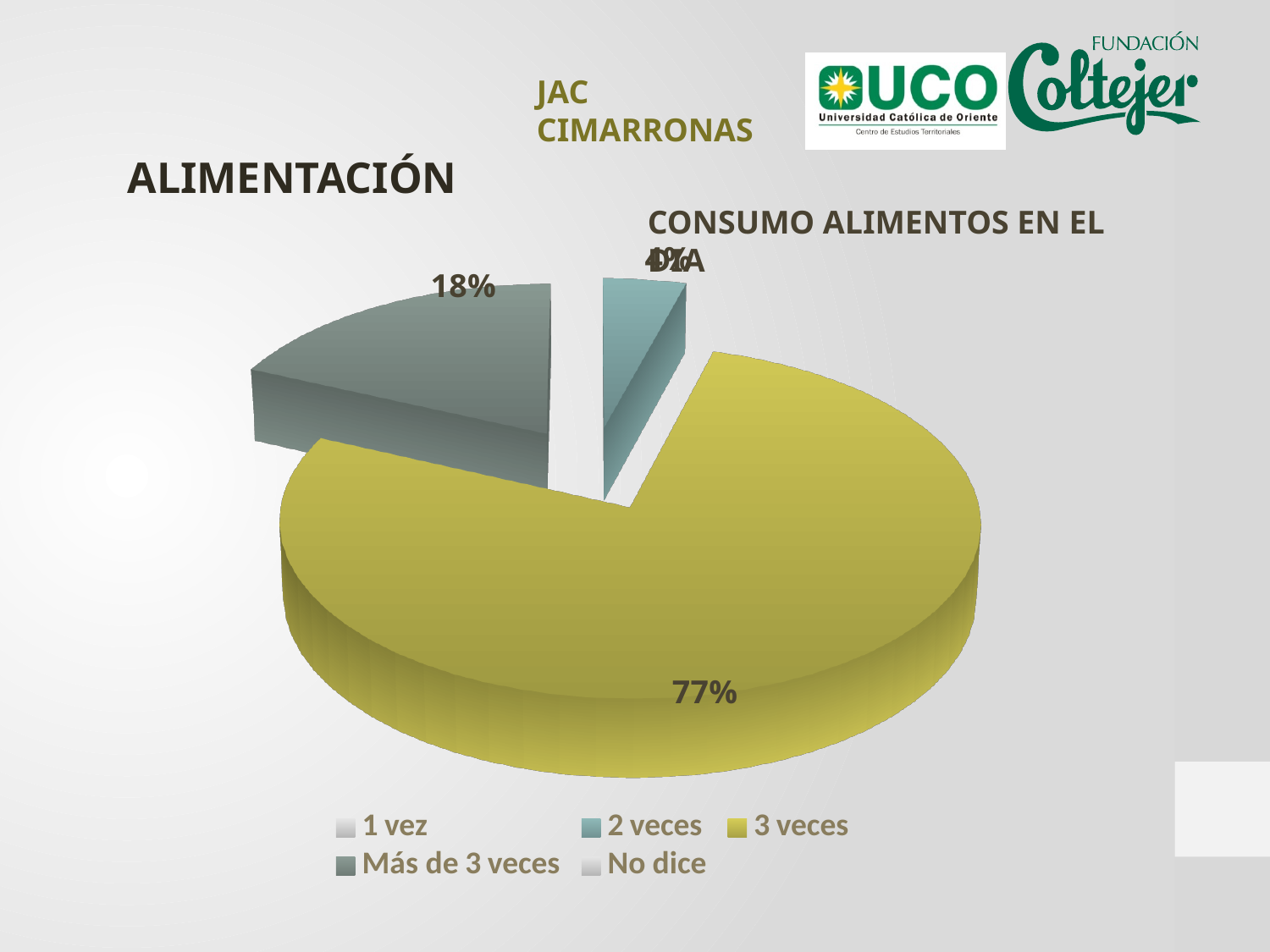
Is the share for "3 veces" greater or less than 50%? greater What colour is the "3 veces" slice of the pie? Yellow What is the difference in percentage points between the "3 veces" slice and the "Más de 3 veces" slice? 59 percentage points What percentage of the pie corresponds to "3 veces"? 77% What percentage of the pie corresponds to "Más de 3 veces"? 18% What kind of chart is shown on the slide? Pie chart Which is larger, the "2 veces" slice or the "Más de 3 veces" slice? Más de 3 veces Which legend entry comes first in the chart's legend? 1 vez Which is larger, the "3 veces" slice or the "Más de 3 veces" slice? 3 veces Which category has the largest share of the pie? 3 veces How many categories does the legend list? 5